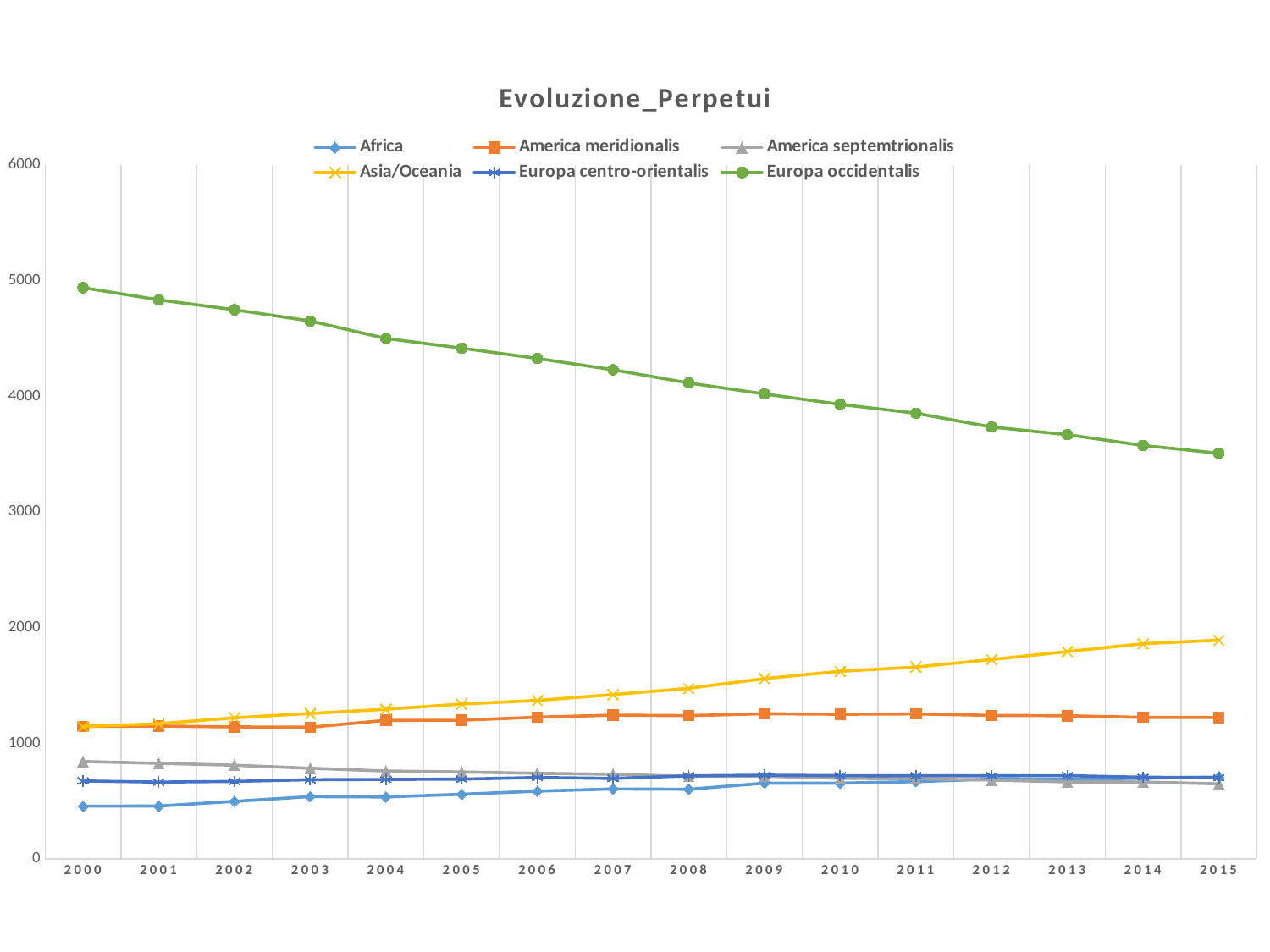
What is the title of the chart? Evoluzione_Perpetui Which series has the highest value in 2000? Europa occidentalis Is the value for Europa occidentalis in 2000 greater or less than 4000? greater Which series has the lowest value in 2000? Africa Does the value for Asia/Oceania rise or fall from 2000 to 2015? rise In 2015, which is larger: Asia/Oceania or America meridionalis? Asia/Oceania Is the value for Africa in 2000 greater or less than 1000? less How many series does the legend list? 6 What kind of chart is shown on the slide? line chart How many years are shown along the x axis? 16 Does the value for Europa occidentalis rise or fall from 2000 to 2015? fall Is the value for Europa occidentalis in 2015 greater or less than 4000? less